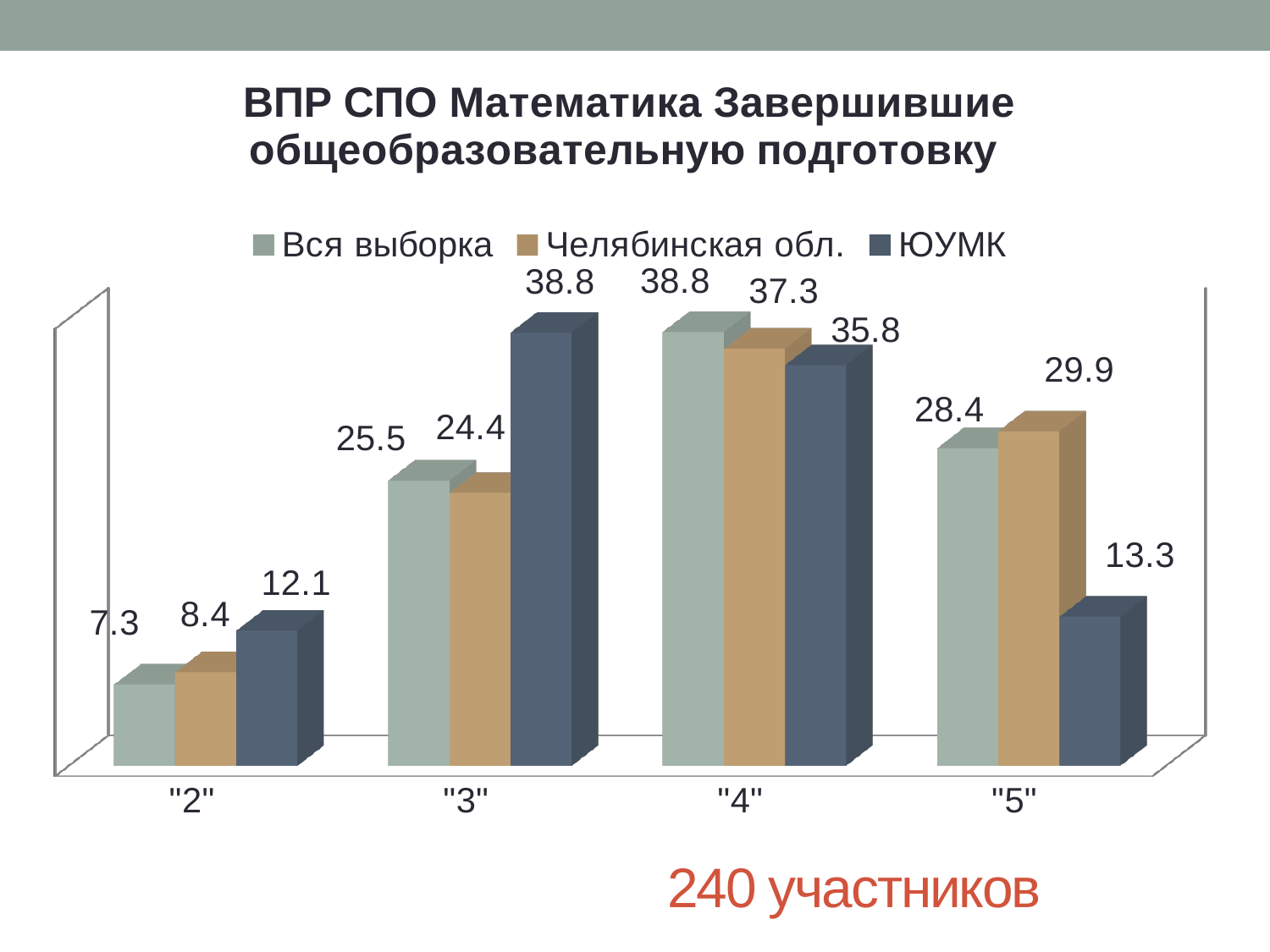
Which is larger in category "4": Вся выборка or ЮУМК? Вся выборка How many categories are shown on the x axis? 4 What is the value for Вся выборка in category "2"? 7.3 How many series does the legend list? 3 In which category is the Вся выборка value the highest? "4" What are the three series listed in the legend? Вся выборка, Челябинская обл., ЮУМК What is the difference between the Челябинская обл. value and the ЮУМК value in category "5"? 16.6 What is the value for Челябинская обл. in category "5"? 29.9 What is the value for ЮУМК in category "3"? 38.8 In which category is the ЮУМК value the lowest? "2" What is the difference between the ЮУМК value and the Вся выборка value in category "3"? 13.3 What kind of chart is shown on the slide? Bar chart